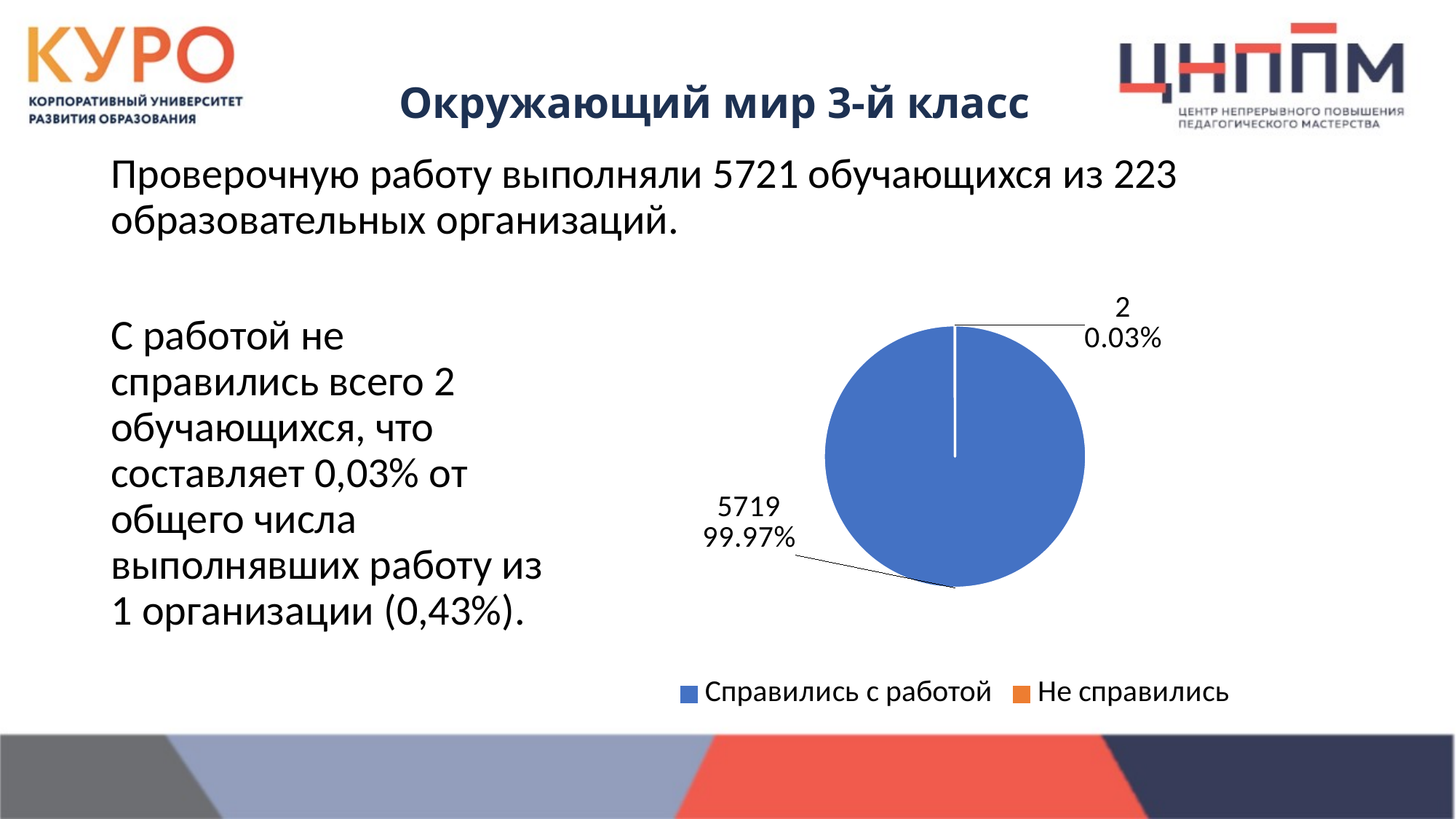
What kind of chart is shown on the slide? Pie chart How many students are in the "Справились с работой" slice of the pie chart? 5719 What share of the pie does the "Не справились" slice represent? 0.03% Which slice of the pie chart is the smallest? Не справились What share of the pie does the "Справились с работой" slice represent? 99.97% How many students are in the "Не справились" slice of the pie chart? 2 What colour is the "Не справились" entry in the legend of the pie chart? Orange Which slice of the pie chart is the largest? Справились с работой What is the difference between the number of students who completed the work and those who did not, according to the pie chart? 5717 How many entries does the legend of the pie chart list? 2 How many slices does the pie chart have? 2 Which is larger in the pie chart: "Справились с работой" or "Не справились"? Справились с работой